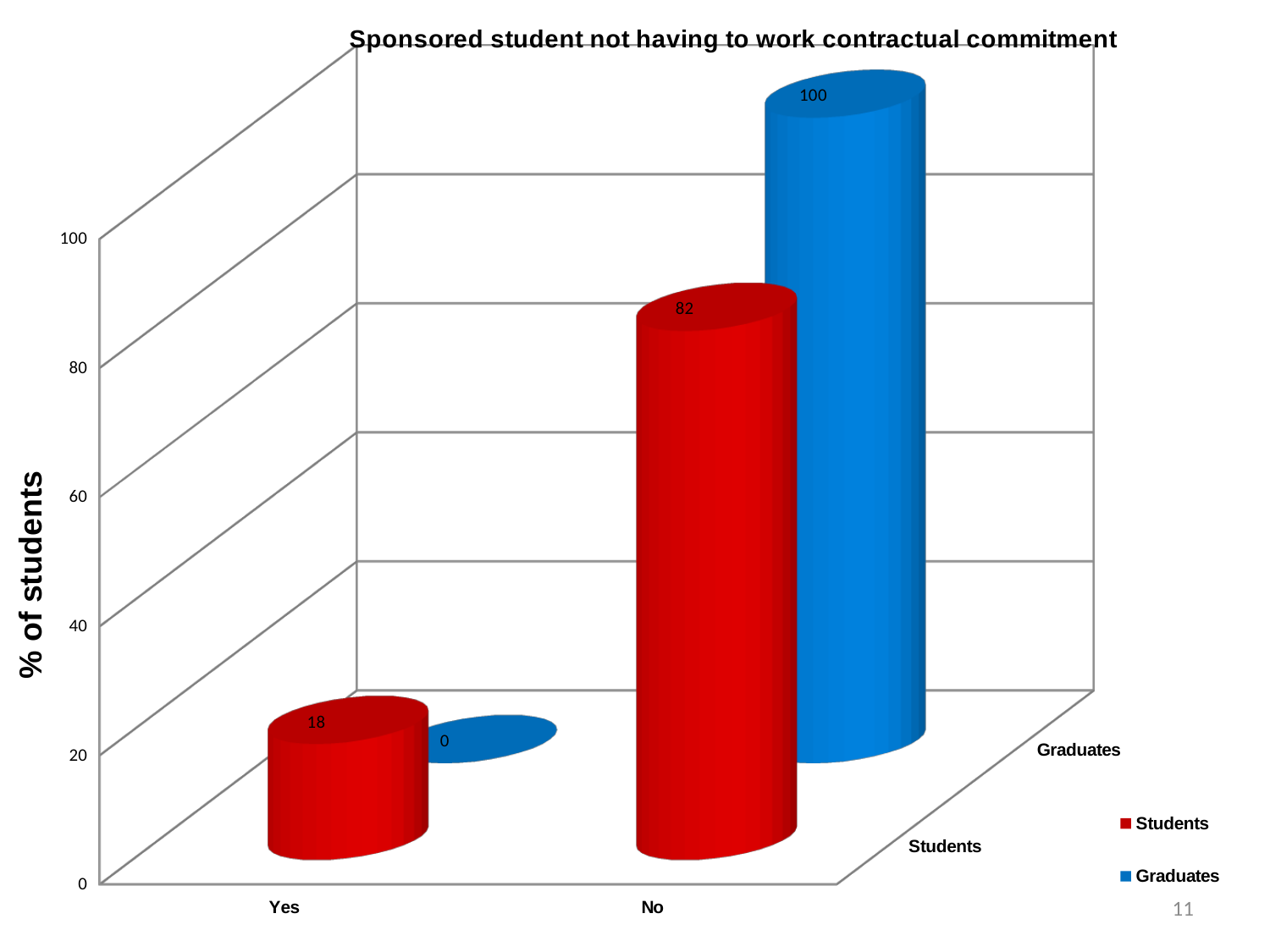
Which series has the highest value in the No category? Graduates What is the value for Graduates in the No category? 100 Is the Students value for No larger than the Graduates value for No? No What is the difference between the Students values for No and Yes? 64 How many categories are shown on the x axis? 2 What is the value for Students in the No category? 82 Which series has the lowest value in the Yes category? Graduates What is the label of the vertical axis? % of students How many series does the legend list? 2 What is the value for Graduates in the Yes category? 0 What kind of chart is shown on the slide? Bar chart What is the value for Students in the Yes category? 18